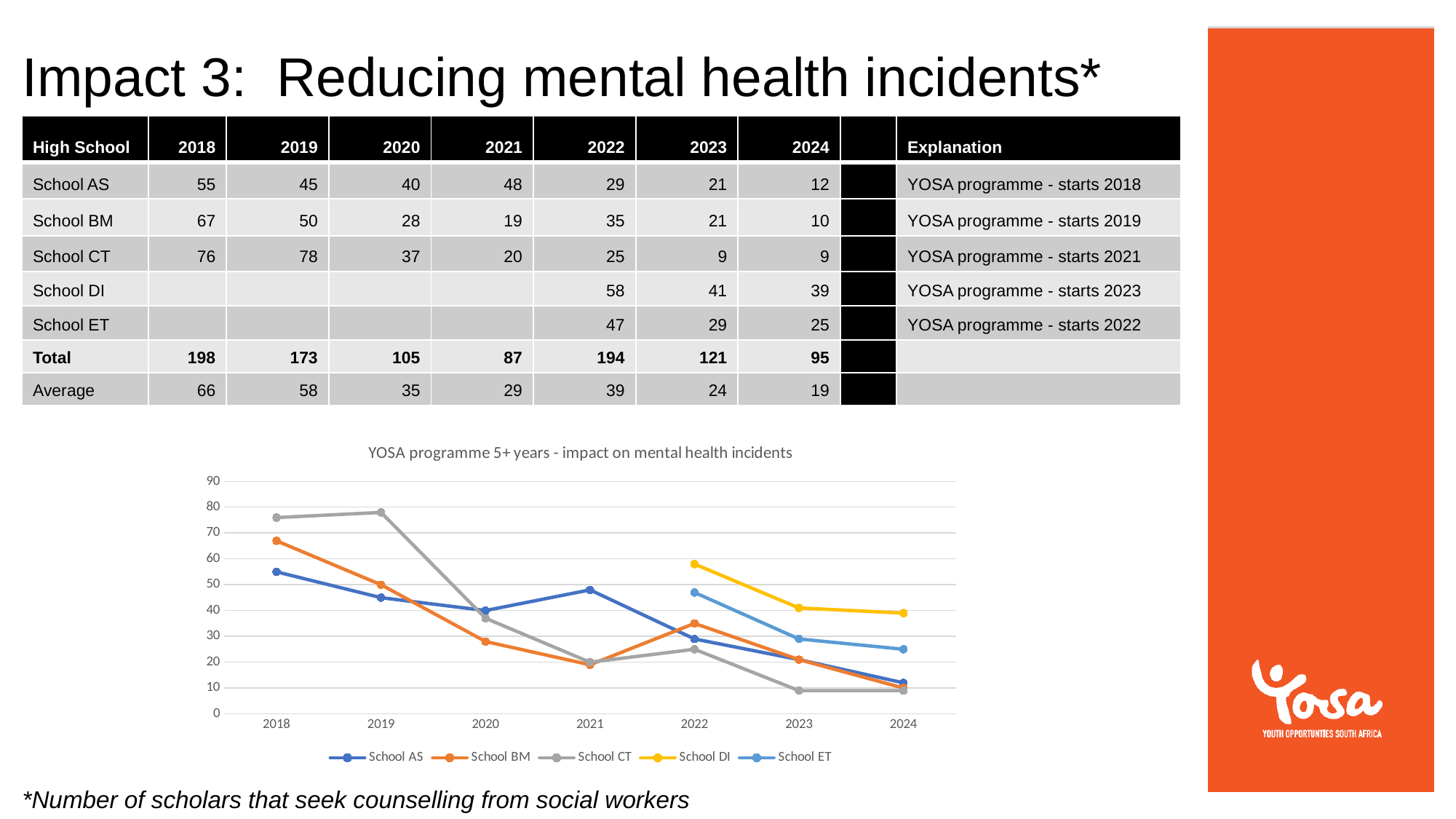
How many years are shown along the x axis of the chart? 7 In 2022, which is larger: the value for School DI or the value for School ET? School DI What is the difference between School DI's value in 2022 and its value in 2024? 19 What is the title of the chart? YOSA programme 5+ years - impact on mental health incidents What kind of chart is shown on the slide? line chart What is the value for School CT in 2019? 78 Is the value for School AS in 2021 greater or less than 40? greater Which school has the highest value in 2018? School CT How many series does the chart legend list? 5 Do the values for School CT rise or fall from 2019 to 2024? fall Which school has the lowest value in 2023? School CT What is the value for School ET in 2023? 29